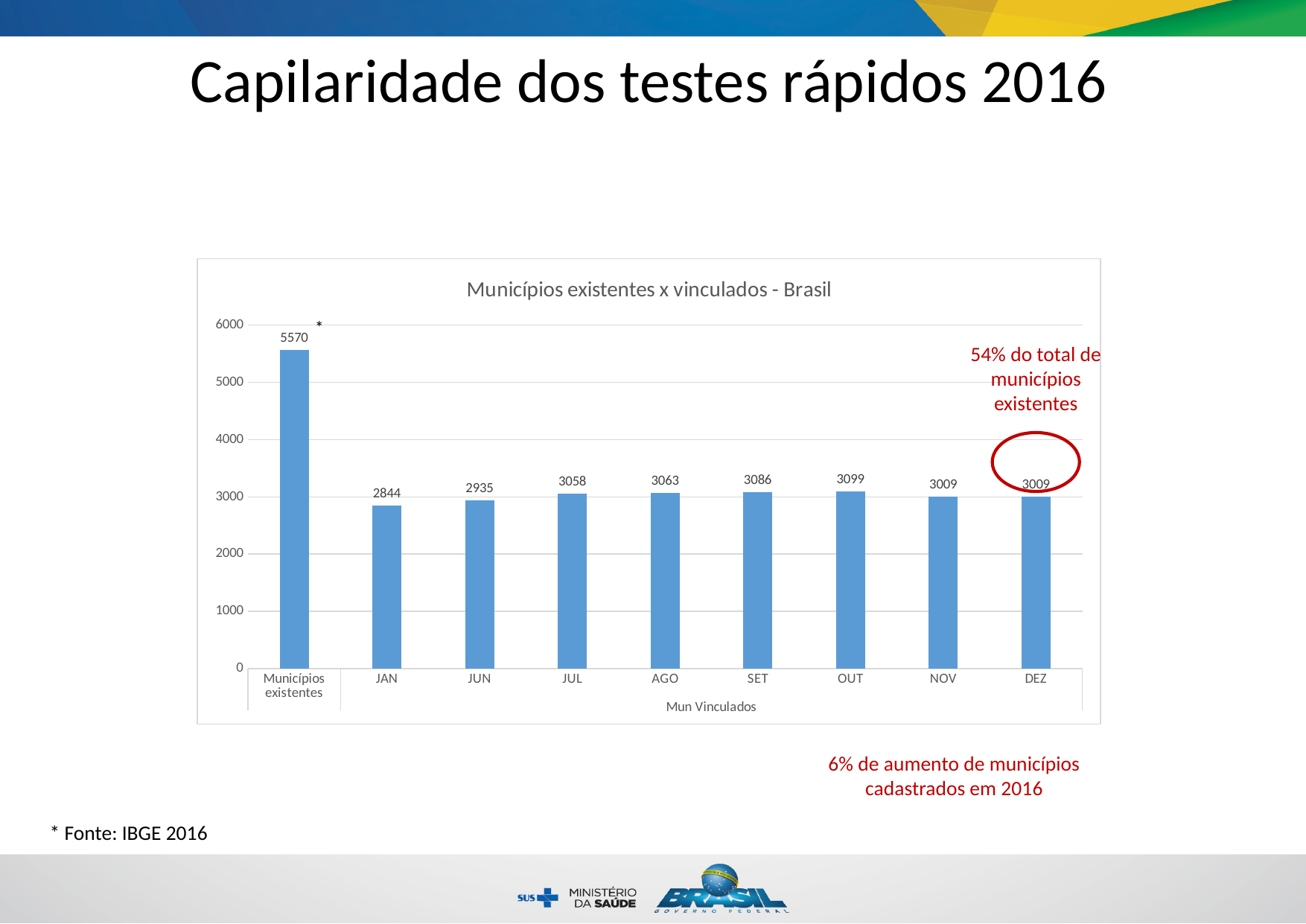
What is the difference between the values for OUT and NOV? 90 Which month has the lowest value? JAN What is the value for Municípios existentes? 5570 Which category has the highest value? Municípios existentes Is the value for JAN greater or less than 3000? less What is the title of the chart? Municípios existentes x vinculados - Brasil What is the value for JAN? 2844 How many bars are shown in the chart? 9 Which is larger, the value for JUN or the value for SET? SET What is the value for DEZ? 3009 What is the difference between the values for Municípios existentes and DEZ? 2561 What is the value for OUT? 3099